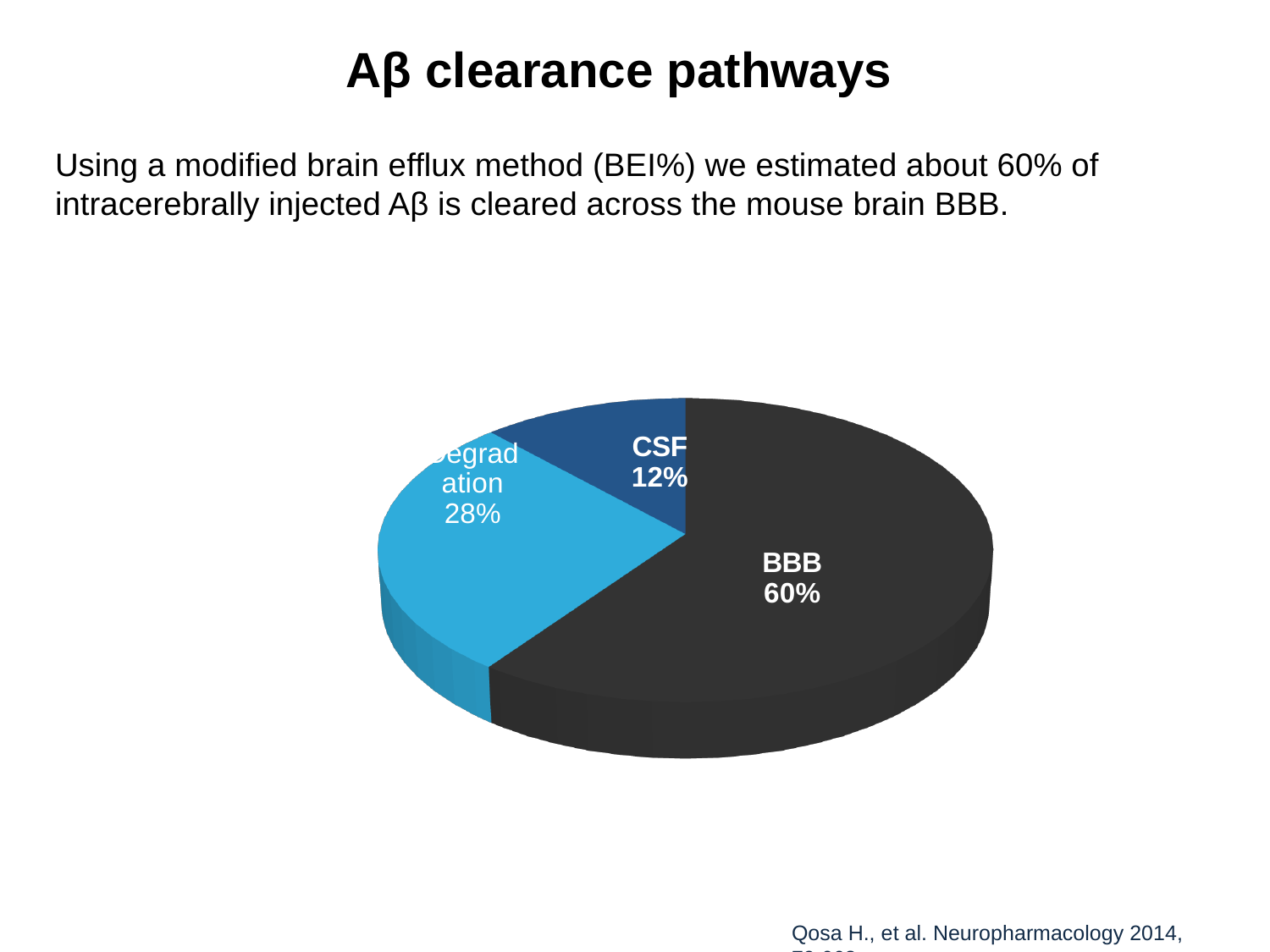
What share of the pie does the BBB slice represent? 60% What is the difference in percentage points between the BBB slice and the Degradation slice? 32 Which slice of the pie is the largest? BBB What share of the pie does the CSF slice represent? 12% Which is larger, the Degradation slice or the CSF slice? Degradation Which slice of the pie is the smallest? CSF Is the share for BBB greater or less than 50%? greater What is the difference in percentage points between the Degradation slice and the CSF slice? 16 What share of the pie does the Degradation slice represent? 28% How many slices does the pie chart have? 3 What kind of chart is shown on the slide? pie chart What colour is the BBB slice of the pie chart? dark grey